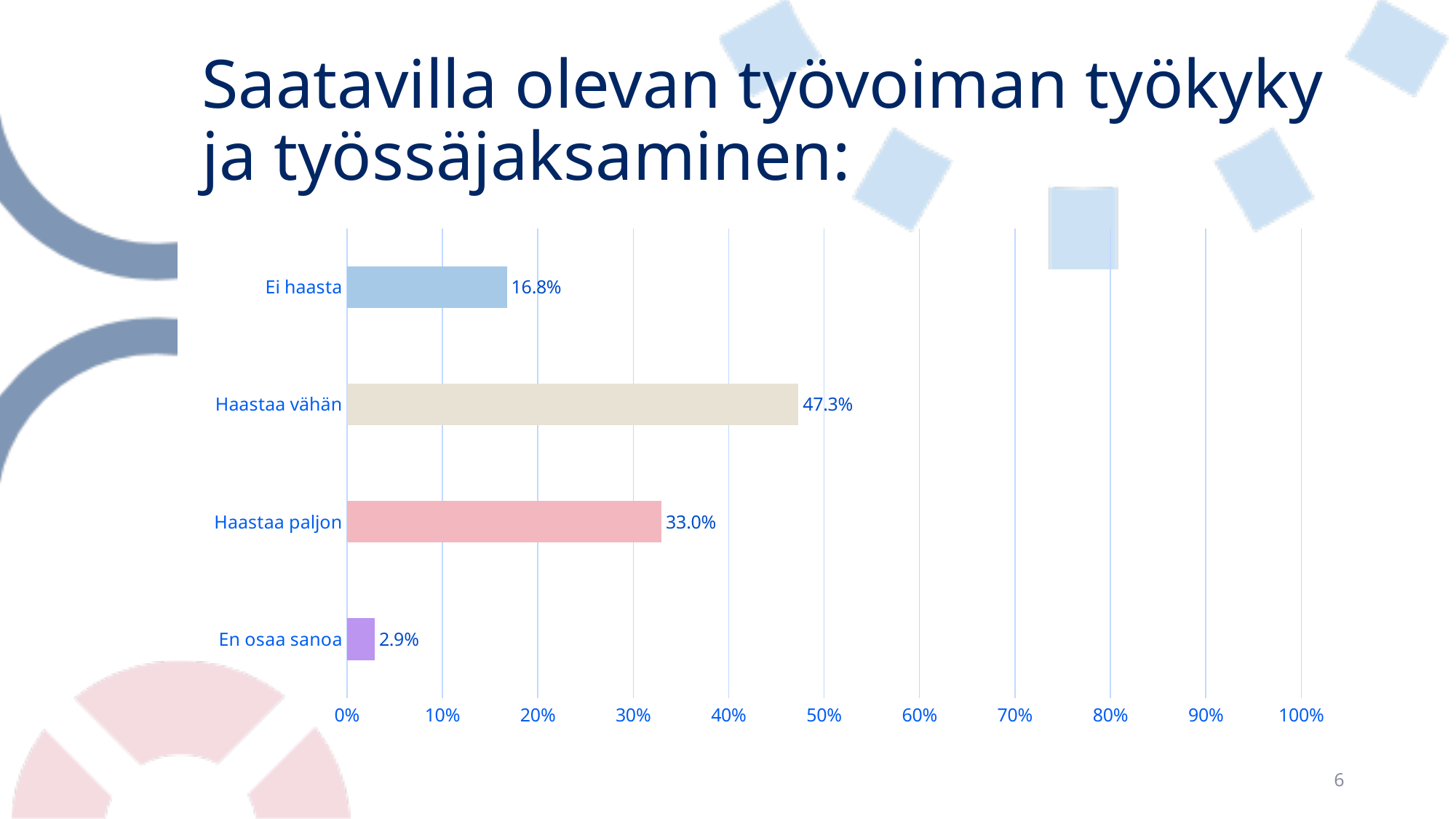
What is the value for "En osaa sanoa"? 2.9% Is the value for "Haastaa vähän" greater or less than 40%? greater How many categories are shown in the chart? 4 Which is larger, the value for "Ei haasta" or the value for "Haastaa paljon"? Haastaa paljon What is the difference between the values for "Haastaa vähän" and "Haastaa paljon"? 14.3% What is the value for "Haastaa vähän"? 47.3% What is the value for "Ei haasta"? 16.8% Which category has the highest value? Haastaa vähän What is the highest value shown on the x axis? 100% Which category has the lowest value? En osaa sanoa What kind of chart is shown on the slide? bar chart What is the value for "Haastaa paljon"? 33.0%